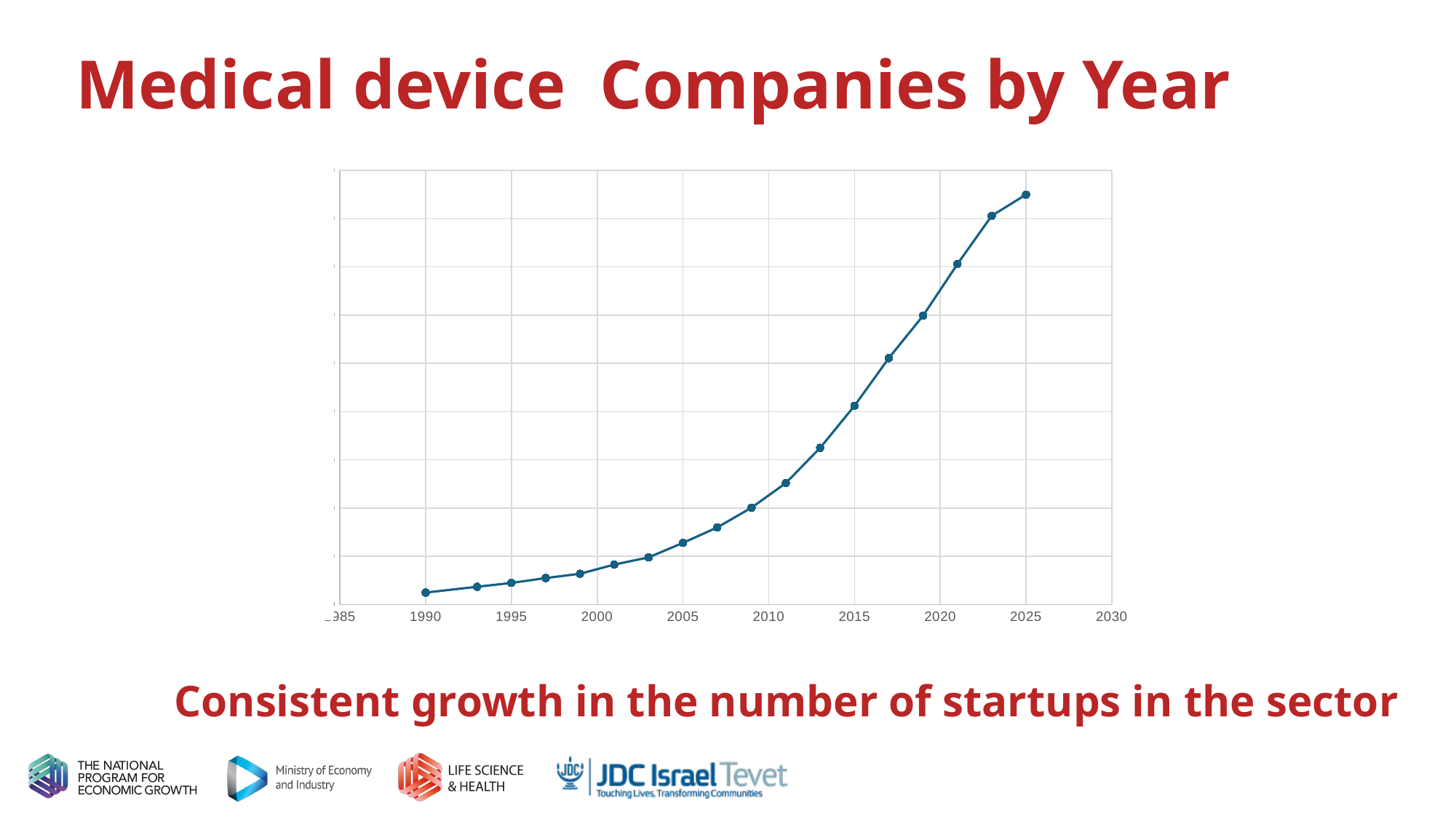
Is the value for 2023 larger or smaller than the value for 2021? larger Which year has the larger value, 1995 or 2015? 2015 How many lines (series) are plotted in the chart? 1 Do the values in the chart rise or fall as the years increase along the x axis? rise What is the title of the slide containing the chart? Medical device Companies by Year Which year has the larger value, 2019 or 2009? 2019 In which year does the line have its lowest value? 1990 What is the earliest year with a plotted data point? 1990 What kind of chart is shown on the slide? line chart How many data points are plotted on the line? 18 In which year does the line reach its highest value? 2025